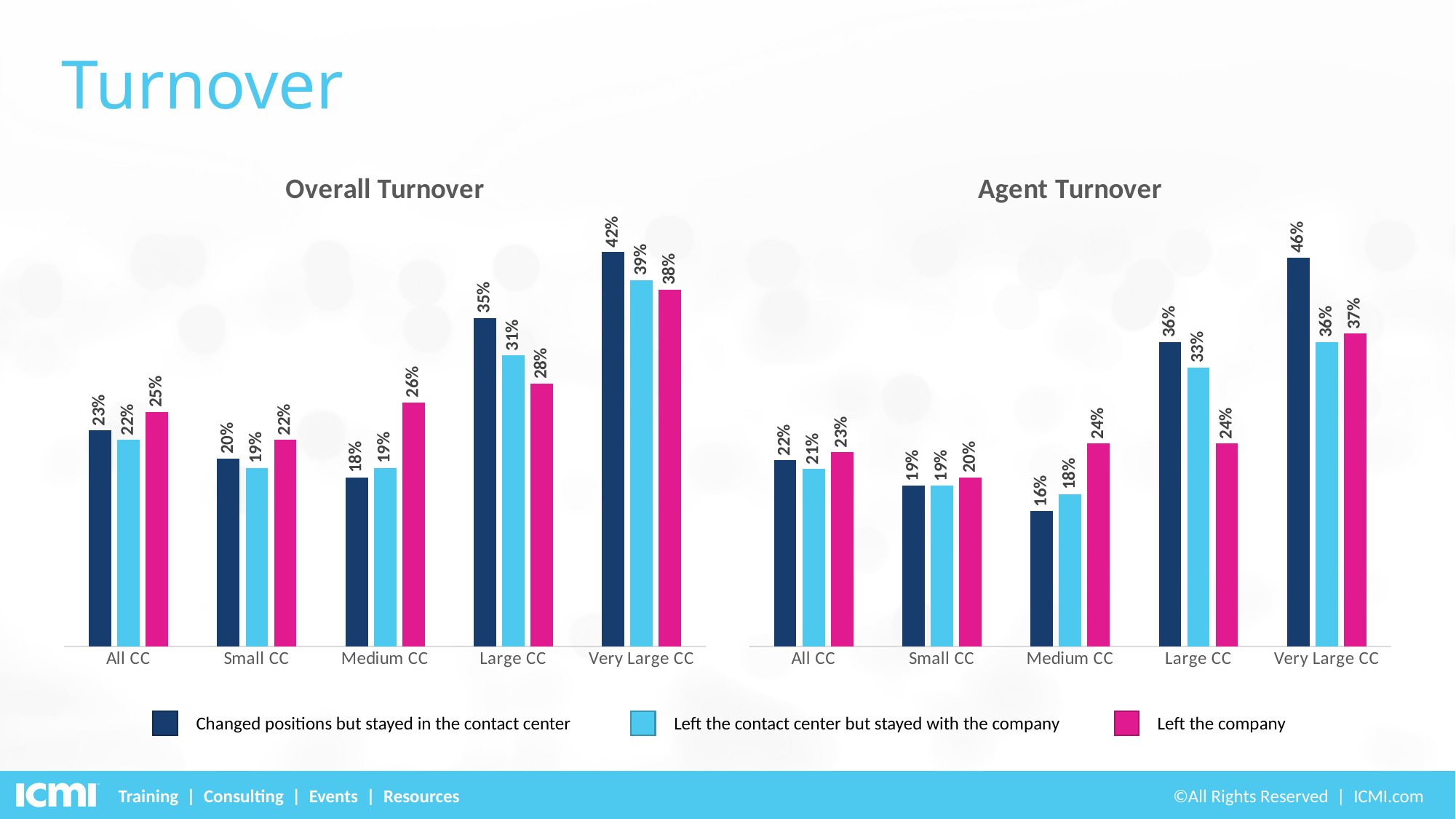
In the Agent Turnover chart, which category has the highest value for 'Changed positions but stayed in the contact center'? Very Large CC In the Agent Turnover chart, which category has the lowest value for 'Changed positions but stayed in the contact center'? Medium CC In the Agent Turnover chart, what is the value for 'Left the company' for Medium CC? 24% What kind of chart is the Overall Turnover chart? Bar chart In the Overall Turnover chart, what is the value for 'Left the contact center but stayed with the company' for Large CC? 31% In the Overall Turnover chart, which is larger for Medium CC: 'Changed positions but stayed in the contact center' or 'Left the company'? Left the company In the Agent Turnover chart, what is the difference between the 'Left the contact center but stayed with the company' value and the 'Left the company' value for Large CC? 9% How many categories are shown on the x axis of the Agent Turnover chart? 5 How many series does the legend list? 3 In the Overall Turnover chart, what is the value for 'Changed positions but stayed in the contact center' for Very Large CC? 42% Which colour represents 'Left the company' in the legend? Pink In the Overall Turnover chart, what is the difference between the 'Changed positions but stayed in the contact center' value and the 'Left the company' value for Large CC? 7%